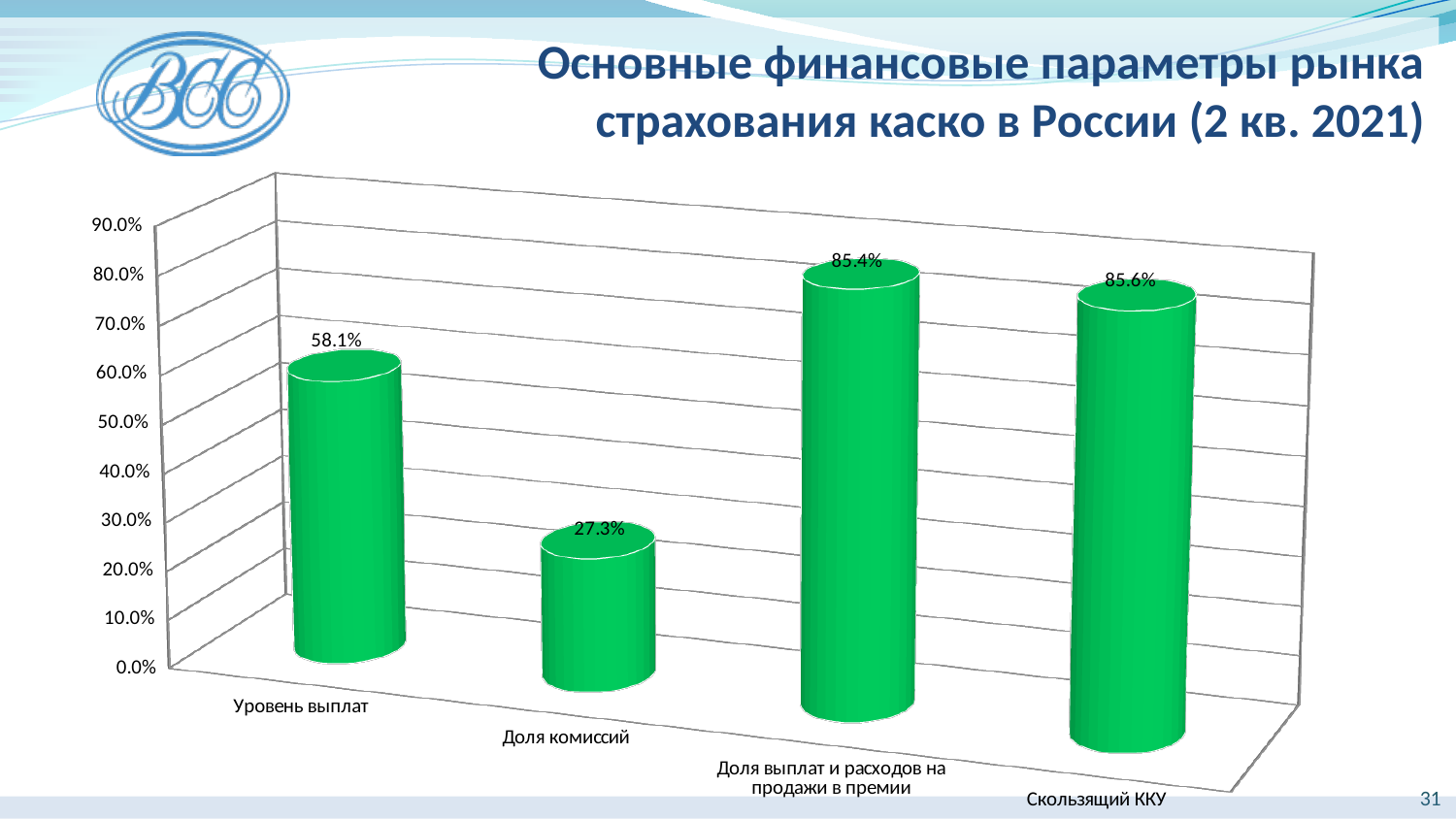
Is the value for Доля комиссий greater or less than 30.0%? less What kind of chart is shown on the slide? Bar chart What is the value for Доля комиссий? 27.3% Which category has the lowest value? Доля комиссий Which category has the highest value according to the data labels? Скользящий ККУ Which is larger, the value for Уровень выплат or the value for Доля комиссий? Уровень выплат What is the value for Доля выплат и расходов на продажи в премии? 85.4% How many categories are shown in the chart? 4 What is the difference between the values for Скользящий ККУ and Уровень выплат? 27.5 percentage points What is the value for Скользящий ККУ? 85.6% What is the value for Уровень выплат? 58.1% What is the difference between the values for Уровень выплат and Доля комиссий? 30.8 percentage points